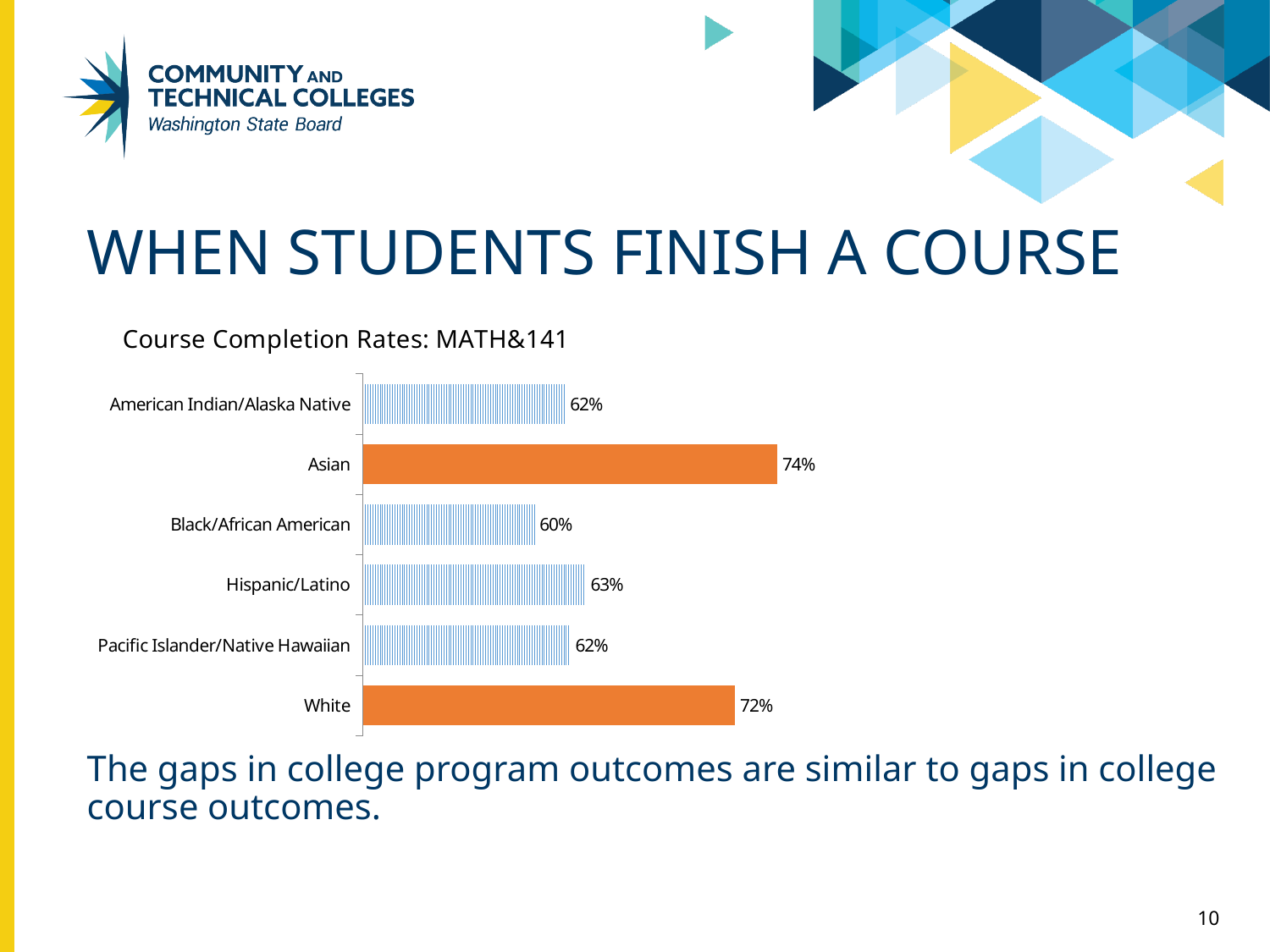
What is the difference between the completion rates for Asian and Black/African American students? 14% What is the course completion rate for Asian students? 74% What kind of chart is shown on the slide? Bar chart What is the title of the chart? Course Completion Rates: MATH&141 What is the course completion rate for White students? 72% How many categories are shown in the chart? 6 Which category has the lowest course completion rate? Black/African American Which is larger, the completion rate for White students or for Asian students? Asian Which category has the highest course completion rate? Asian What is the difference between the completion rates for White and Hispanic/Latino students? 9% What is the course completion rate for Hispanic/Latino students? 63% What is the course completion rate for Black/African American students? 60%